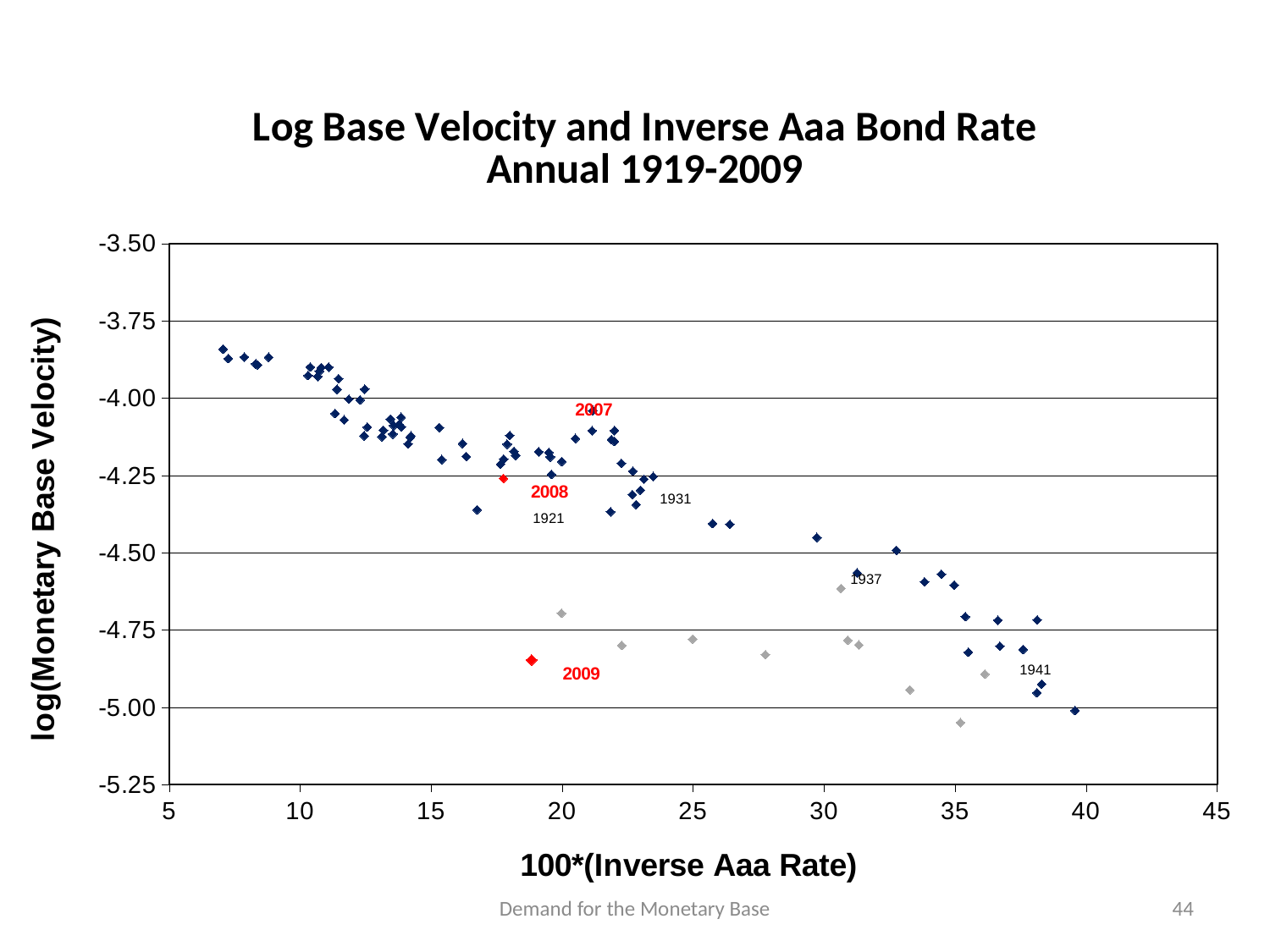
How many points on the chart are labelled with a year? 7 Is the log(Monetary Base Velocity) value for the point labelled 1937 greater or less than -4.50? less Is the x-axis value (100*(Inverse Aaa Rate)) for the point labelled 2009 greater or less than 20? less What is the title of the chart? Log Base Velocity and Inverse Aaa Bond Rate Annual 1919-2009 As the x-axis value increases, do the plotted log(Monetary Base Velocity) values generally rise or fall? fall Is the x-axis value (100*(Inverse Aaa Rate)) for the point labelled 1941 greater or less than 35? greater What is the label of the x axis? 100*(Inverse Aaa Rate) Which labelled point has the higher log(Monetary Base Velocity), 2007 or 2009? 2007 What kind of chart is shown on the slide? scatter plot